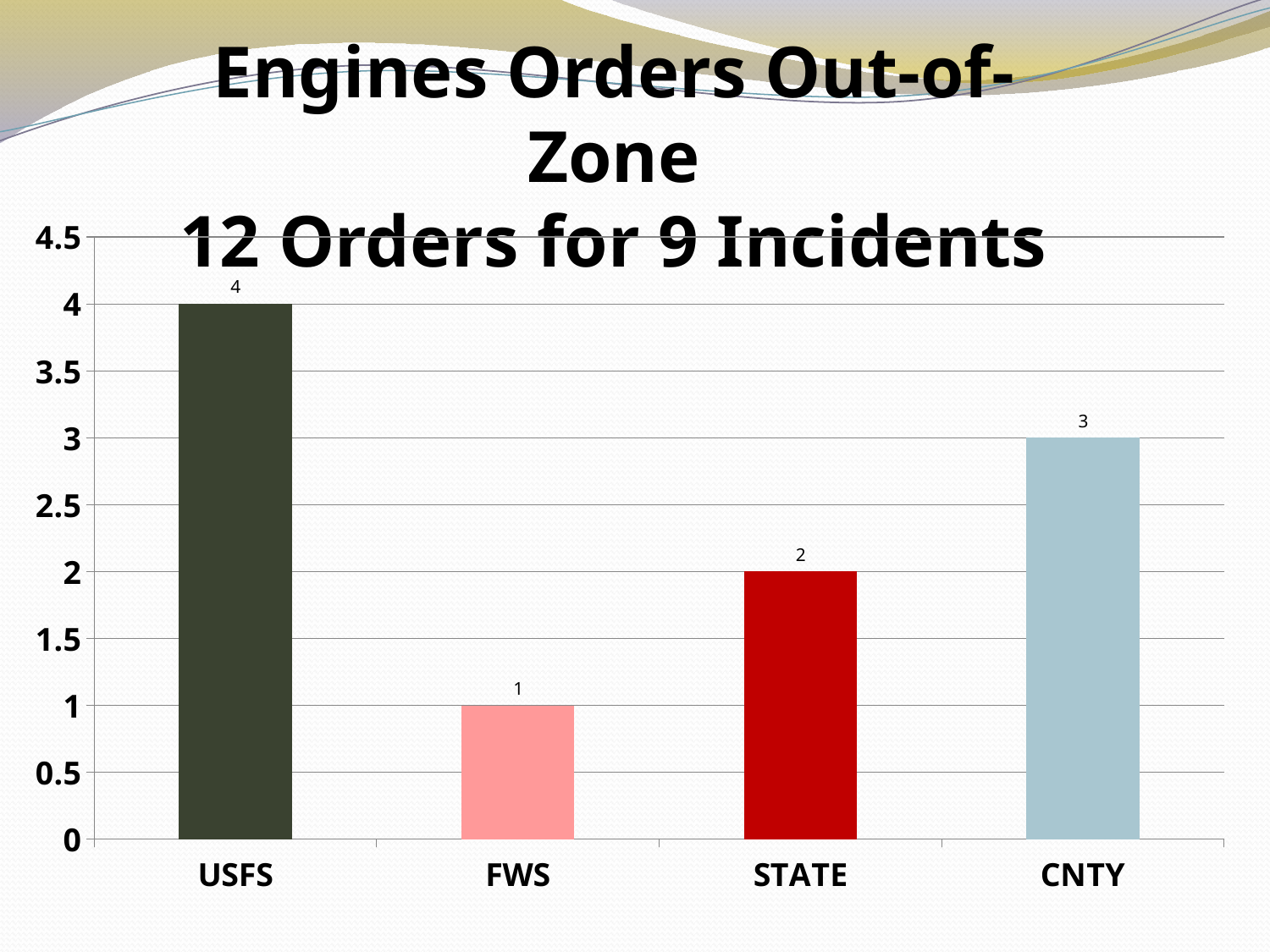
What kind of chart is shown on the slide? bar chart Which category has the lowest value? FWS What is the value for USFS? 4 Which category has the highest value? USFS What is the value for CNTY? 3 What is the value for STATE? 2 Which is larger, the value for STATE or the value for CNTY? CNTY How many categories are shown on the x axis? 4 What is the difference between the values for CNTY and STATE? 1 What is the title of the slide? Engines Orders Out-of-Zone 12 Orders for 9 Incidents What is the value for FWS? 1 What is the difference between the values for USFS and FWS? 3